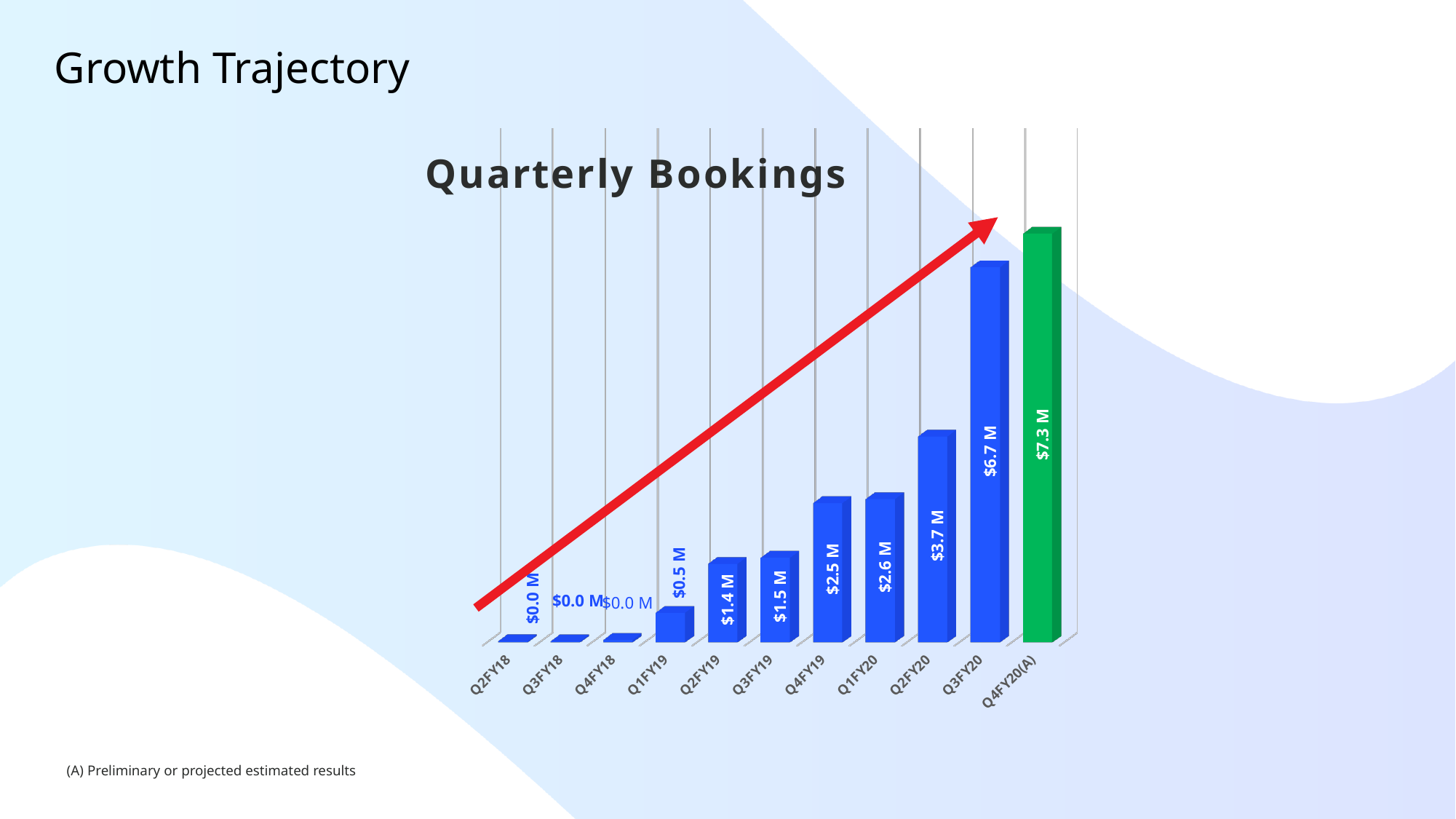
What is the value for Q1FY19? $0.5 M What is the title of the chart? Quarterly Bookings What is the difference between the Q4FY20(A) and Q3FY20 values? $0.6 M Do the bookings values generally rise or fall from Q2FY18 to Q4FY20(A)? rise What is the value for Q4FY20(A)? $7.3 M How many quarters are plotted in the Quarterly Bookings chart? 11 What type of chart is shown on the slide? bar chart Which is larger, the value for Q4FY19 or the value for Q1FY20? Q1FY20 What is the value for Q3FY20? $6.7 M Which quarter has the highest bookings? Q4FY20(A) What is the difference between the Q3FY20 and Q2FY20 values? $3.0 M What is the value for Q2FY20? $3.7 M